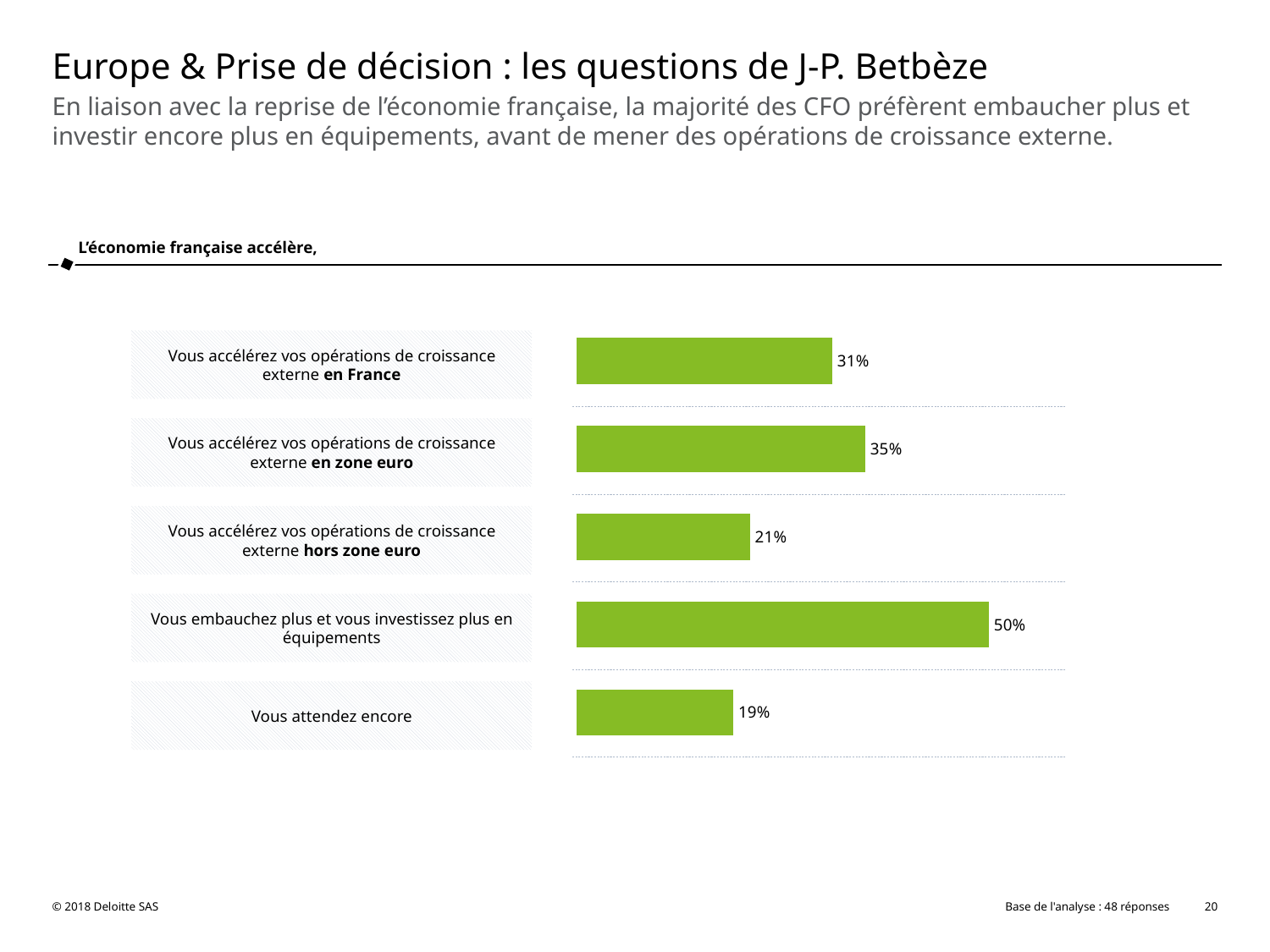
What is the value for "Vous accélérez vos opérations de croissance externe en France"? 31% What is the difference between the values for "en zone euro" and "en France"? 4% What is the value for "Vous accélérez vos opérations de croissance externe en zone euro"? 35% What kind of chart is shown on the slide? Bar chart What is the value for "Vous attendez encore"? 19% Which is larger: the value for "en zone euro" or the value for "hors zone euro"? en zone euro What is the value for "Vous embauchez plus et vous investissez plus en équipements"? 50% How many categories are shown in the chart? 5 Which category has the highest value? Vous embauchez plus et vous investissez plus en équipements What is the value for "Vous accélérez vos opérations de croissance externe hors zone euro"? 21% Which category has the lowest value? Vous attendez encore What is the difference between the values for "Vous embauchez plus et vous investissez plus en équipements" and "Vous attendez encore"? 31%